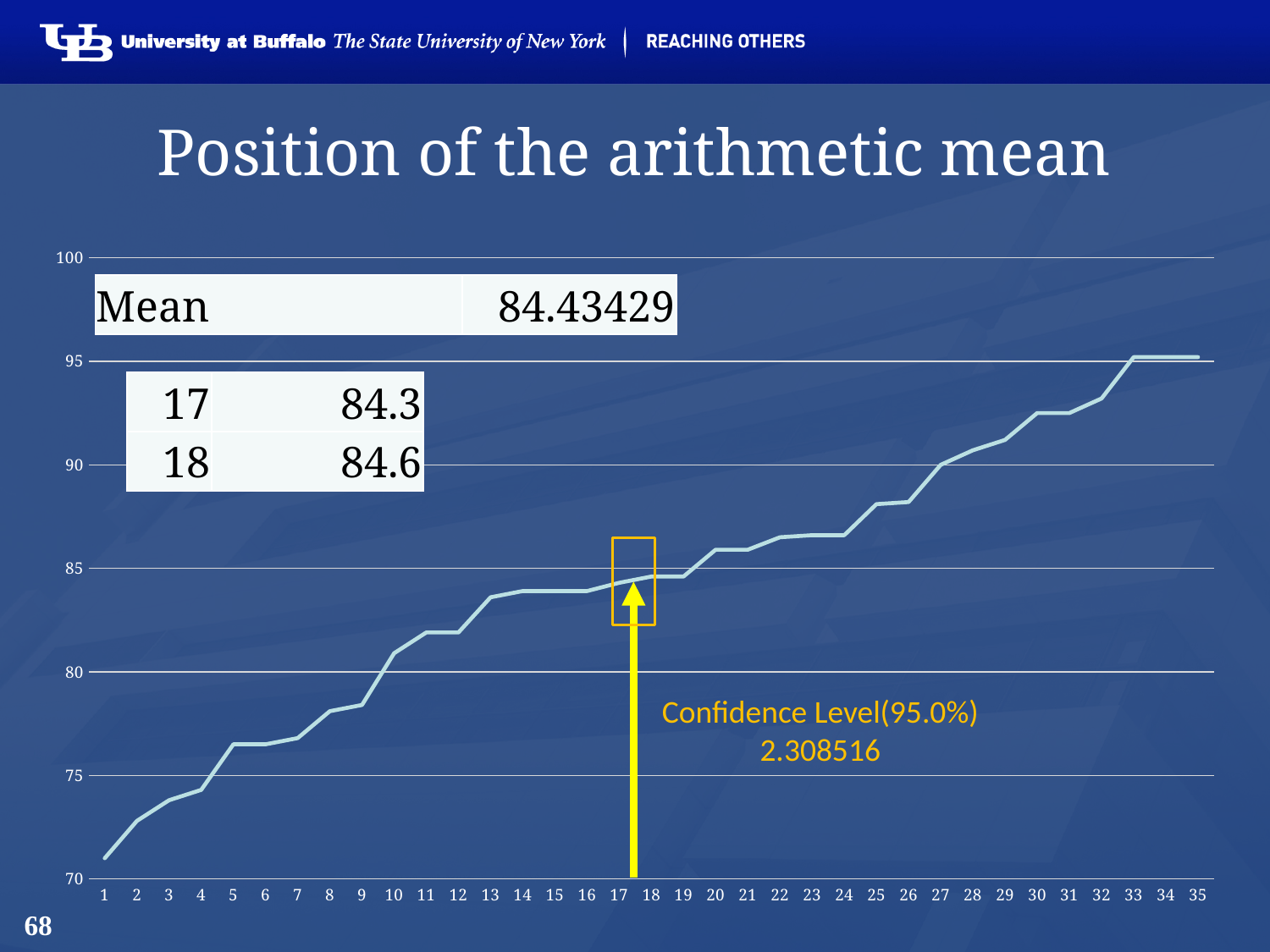
Do the plotted values rise or fall as the x axis goes from 1 to 35? rise What kind of chart is shown on the slide? line chart Which has the larger value, position 17 or position 18? 18 What is the value at position 17? 84.3 What is the mean shown on the slide? 84.43429 Is the value at position 1 greater or less than 75? less How many points are plotted along the x axis? 35 What is the difference between the values at positions 18 and 17? 0.3 Is the value at position 30 greater or less than 90? greater What is the title of the slide's chart? Position of the arithmetic mean Which position has the lowest value? 1 What is the value at position 18? 84.6